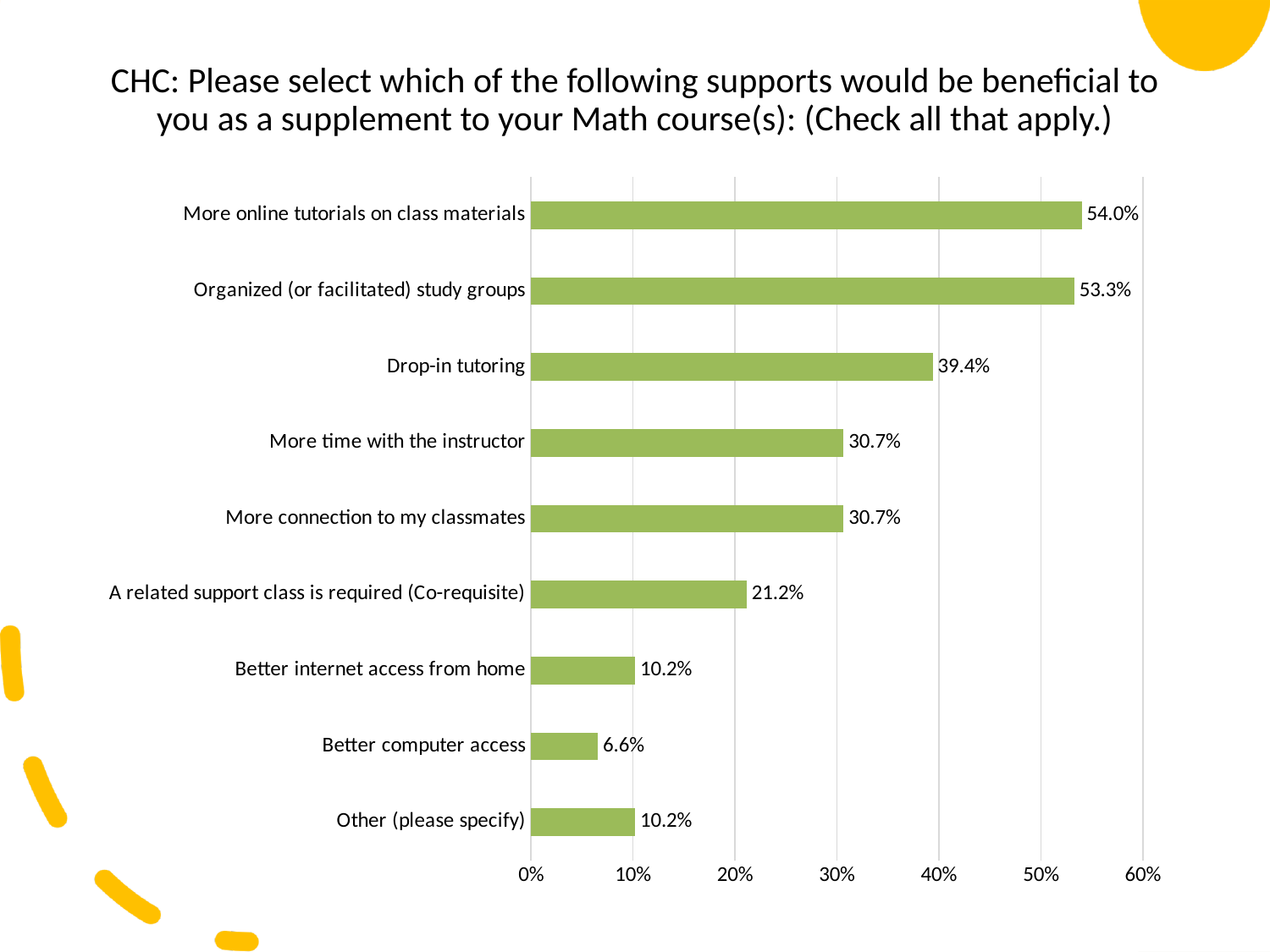
What is the value for "Better computer access"? 6.6% What is the maximum value shown on the horizontal axis? 60% Which support option has the lowest percentage? Better computer access What percentage of respondents selected "Drop-in tutoring"? 39.4% What kind of chart is shown on the slide? Bar chart How many support options are shown in the chart? 9 What is the difference between "Drop-in tutoring" and "More time with the instructor"? 8.7% What is the value for "A related support class is required (Co-requisite)"? 21.2% Which is larger: the value for "Drop-in tutoring" or the value for "More connection to my classmates"? Drop-in tutoring Which support option has the highest percentage? More online tutorials on class materials Is the value for "Organized (or facilitated) study groups" greater or less than 50%? greater What is the difference between "More online tutorials on class materials" and "Organized (or facilitated) study groups"? 0.7%